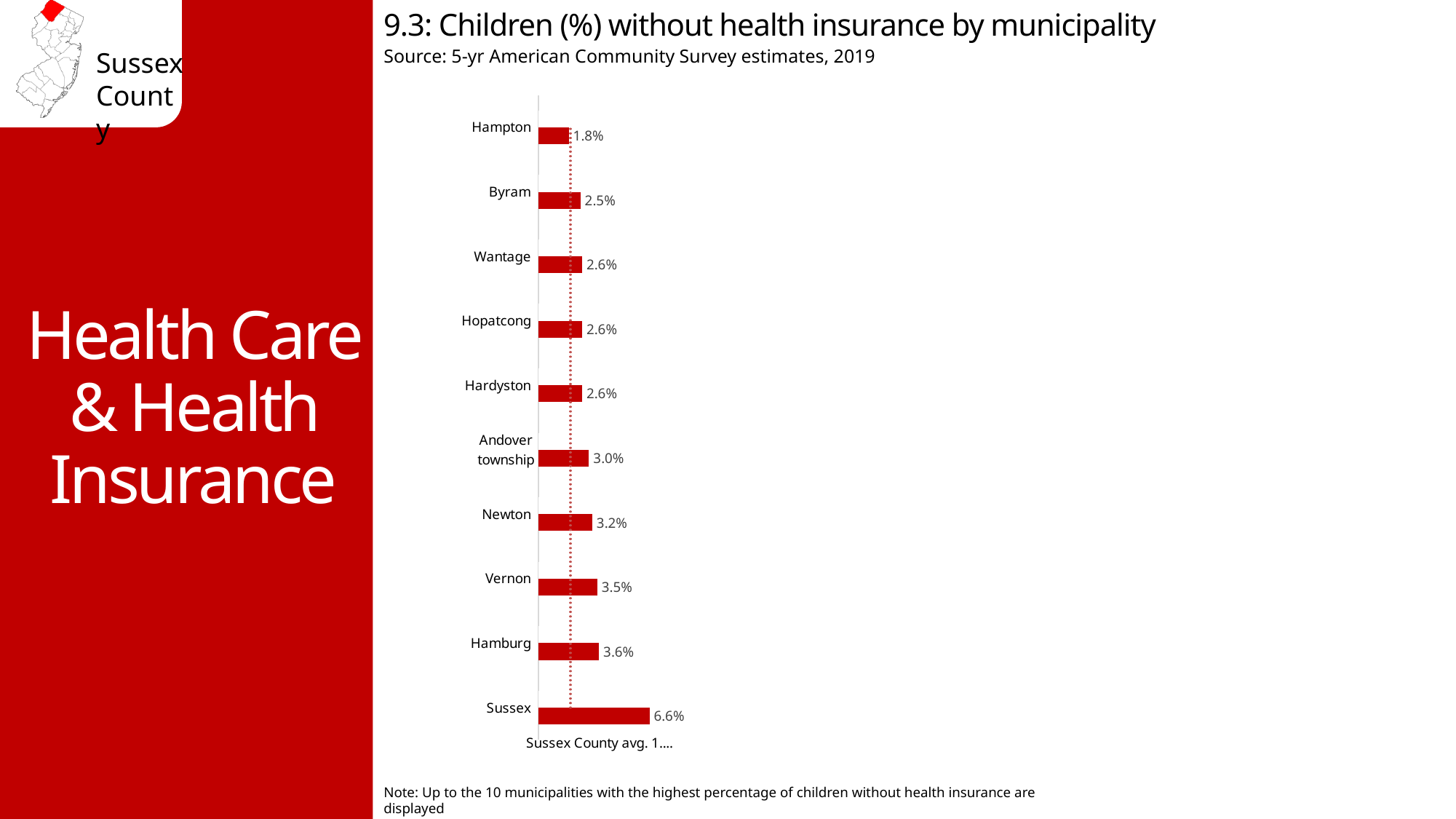
What is the title of the chart? 9.3: Children (%) without health insurance by municipality Which municipality has the lowest percentage of children without health insurance? Hampton What is the difference between the values for Vernon and Byram? 1.0% Which municipality has the highest percentage of children without health insurance? Sussex Which has a higher value, Hamburg or Wantage? Hamburg What is the value shown for Hampton? 1.8% What type of chart is shown on the slide? Bar chart How many municipalities are shown in the chart? 10 What is the difference between the values for Sussex and Hamburg? 3.0% What is the value shown for Andover township? 3.0% What percentage of children in Sussex are without health insurance? 6.6% What is the value shown for Newton? 3.2%